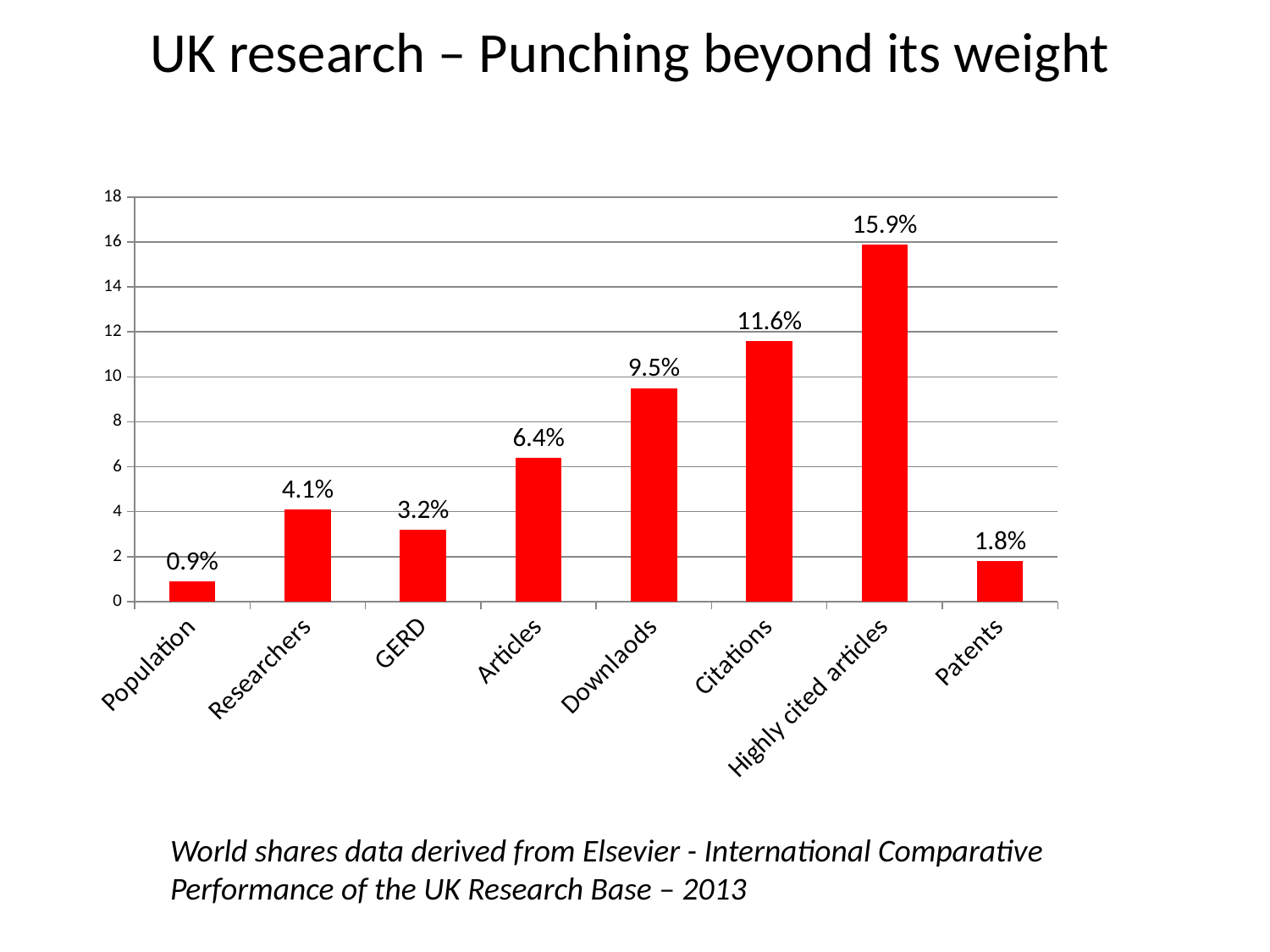
Is the value for Downlaods greater or less than 8? greater What kind of chart is shown on the slide? bar chart What is the value for Highly cited articles? 15.9% How many categories are shown on the x axis? 8 What is the value for GERD? 3.2% What is the value for Citations? 11.6% Which category has the highest value? Highly cited articles Which is larger, the value for Researchers or the value for Patents? Researchers What colour are the bars in the chart? red What is the value for Population? 0.9% What is the difference between the values for Citations and Articles? 5.2% Which category has the lowest value? Population